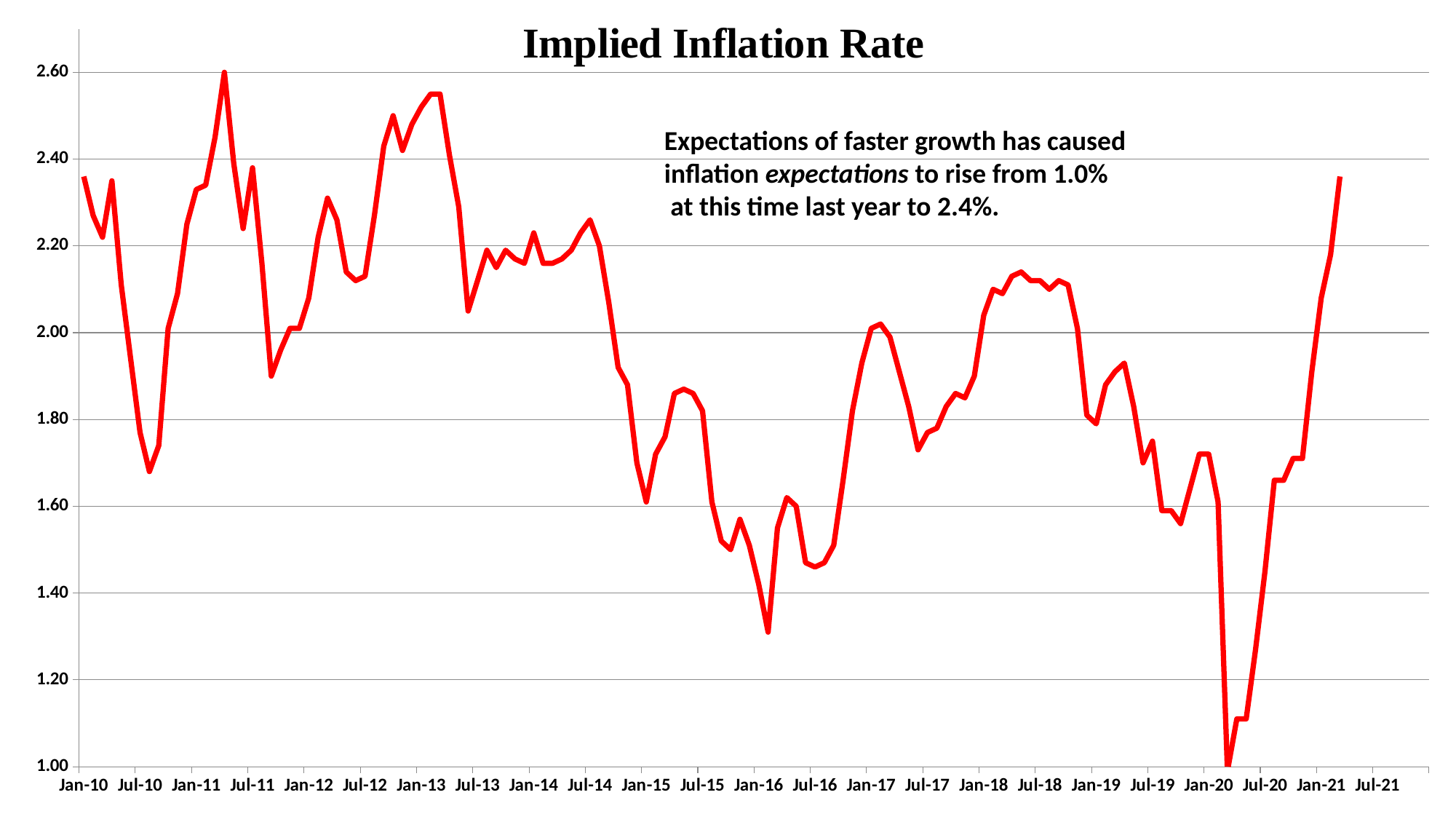
What kind of chart is shown on the slide? line chart What colour is the plotted line? red Does the line rise or fall between Jan-13 and Jan-16? fall In which year does the line reach its lowest point? 2020 What is the title of the chart? Implied Inflation Rate Is the value at Jul-20 greater or less than 1.60? less Is the value at Jan-13 greater or less than 2.40? greater Is the final value of the line, in early 2021, greater or less than 2.20? greater Which is larger, the value at Jan-10 or the value at Jan-21? Jan-10 Does the line rise or fall between Jul-20 and the end of the series? rise